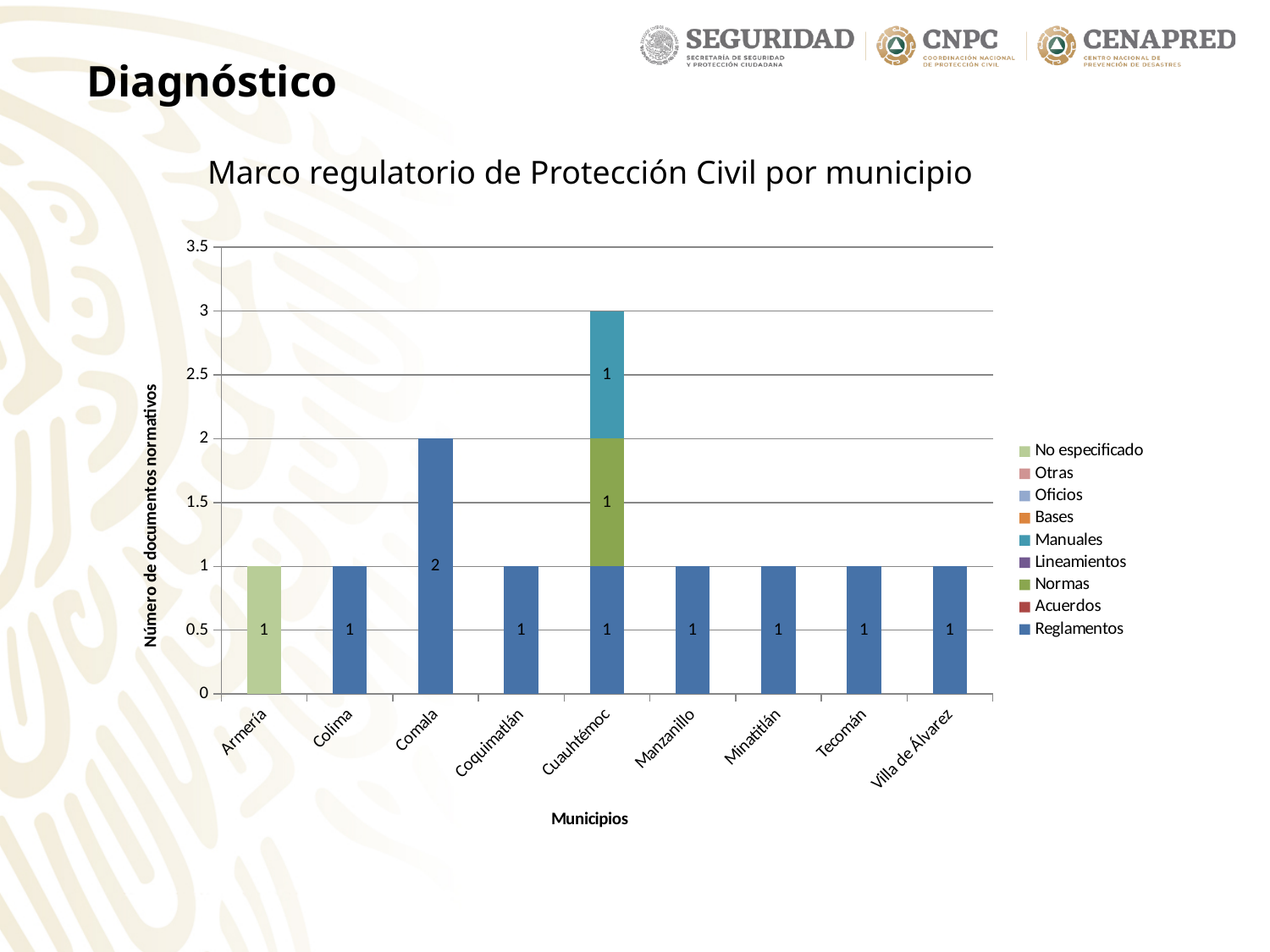
What type of chart is shown on the slide? Stacked bar chart Which municipality has the highest total number of normative documents? Cuauhtémoc What is the value of Normas for Cuauhtémoc? 1 What is the title of the chart? Marco regulatorio de Protección Civil por municipio How many municipalities are shown on the x axis? 9 Which series does the bar for Armería belong to? No especificado What is the difference between the total for Cuauhtémoc and the total for Comala? 1 Which is larger, the total for Comala or the total for Colima? Comala What is the value of Manuales for Cuauhtémoc? 1 What is the value of Reglamentos for Comala? 2 How many series does the legend list? 9 What is the total height of the stacked bar for Cuauhtémoc? 3